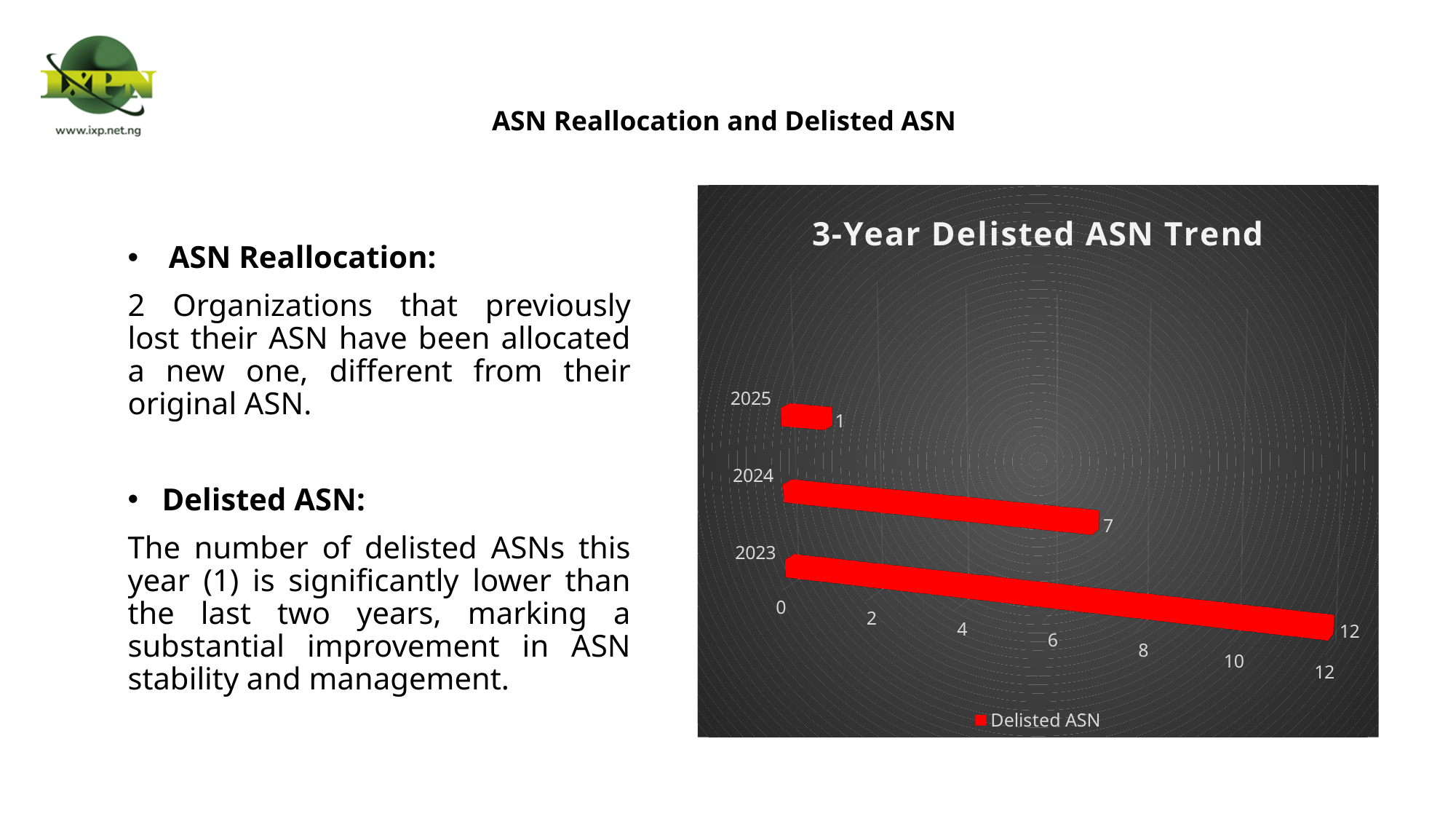
What is the value for 2025 in the 3-Year Delisted ASN Trend chart? 1 Which year has more delisted ASNs, 2024 or 2025? 2024 What kind of chart is the 3-Year Delisted ASN Trend? Bar chart What is the difference between the delisted ASN values for 2023 and 2024? 5 What is the difference between the delisted ASN values for 2024 and 2025? 6 What is the title of the chart on the slide? 3-Year Delisted ASN Trend How many years are shown in the 3-Year Delisted ASN Trend chart? 3 What is the value for 2024 in the 3-Year Delisted ASN Trend chart? 7 Which year has the lowest number of delisted ASNs? 2025 Which year has the highest number of delisted ASNs? 2023 What is the value for 2023 in the 3-Year Delisted ASN Trend chart? 12 How many series does the legend of the chart list? 1